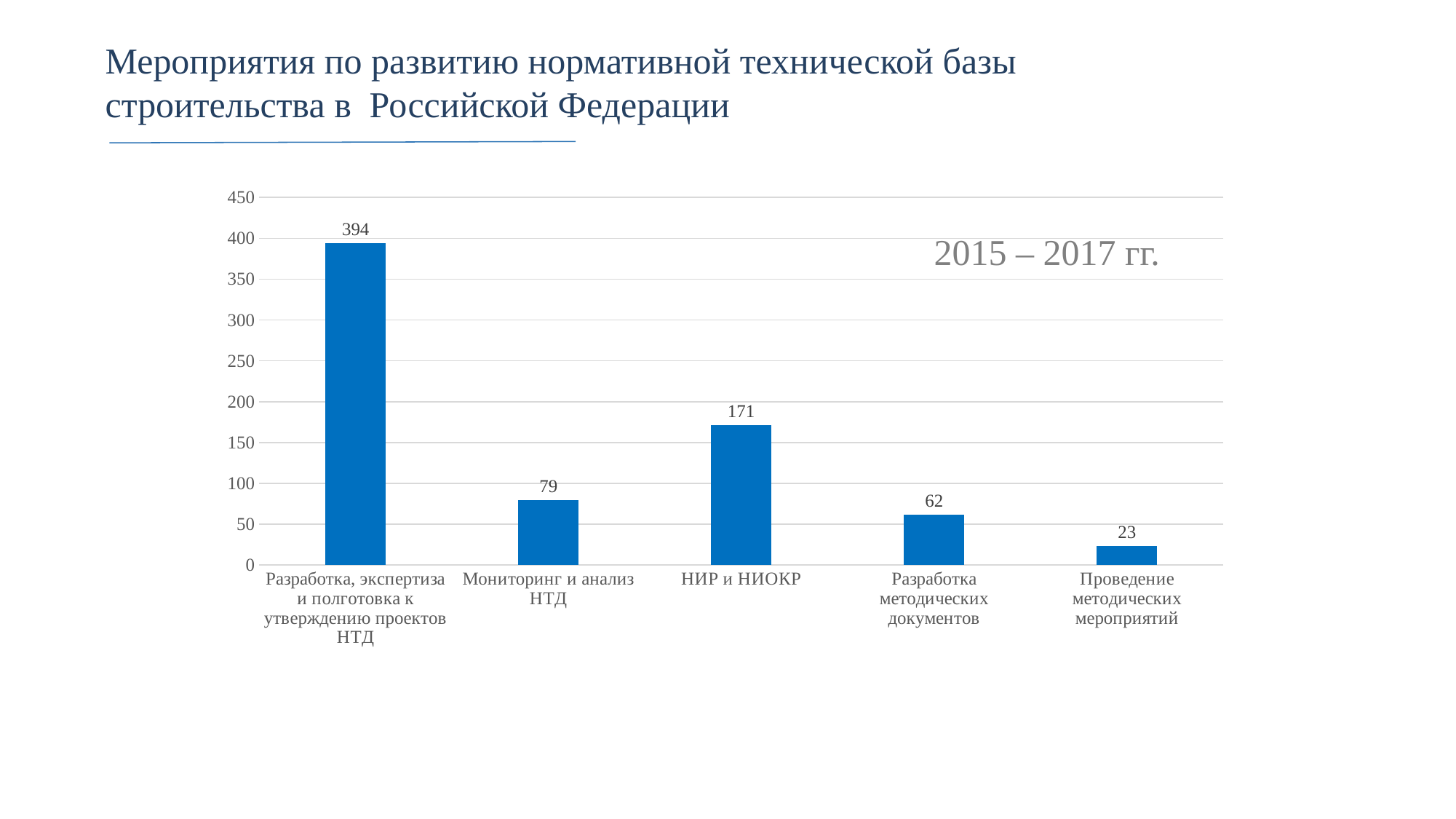
How many categories are shown on the chart? 5 Which is larger, the value for Мониторинг и анализ НТД or the value for Разработка методических документов? Мониторинг и анализ НТД What is the difference between the values for Разработка, экспертиза и полготовка к утверждению проектов НТД and НИР и НИОКР? 223 What is the value for Проведение методических мероприятий? 23 Which category has the lowest value? Проведение методических мероприятий What is the value for Мониторинг и анализ НТД? 79 What kind of chart is shown on the slide? Bar chart What is the value for НИР и НИОКР? 171 Which category has the highest value? Разработка, экспертиза и полготовка к утверждению проектов НТД What is the value for Разработка методических документов? 62 What is the highest value shown on the vertical axis? 450 What period is indicated on the chart? 2015 – 2017 гг.